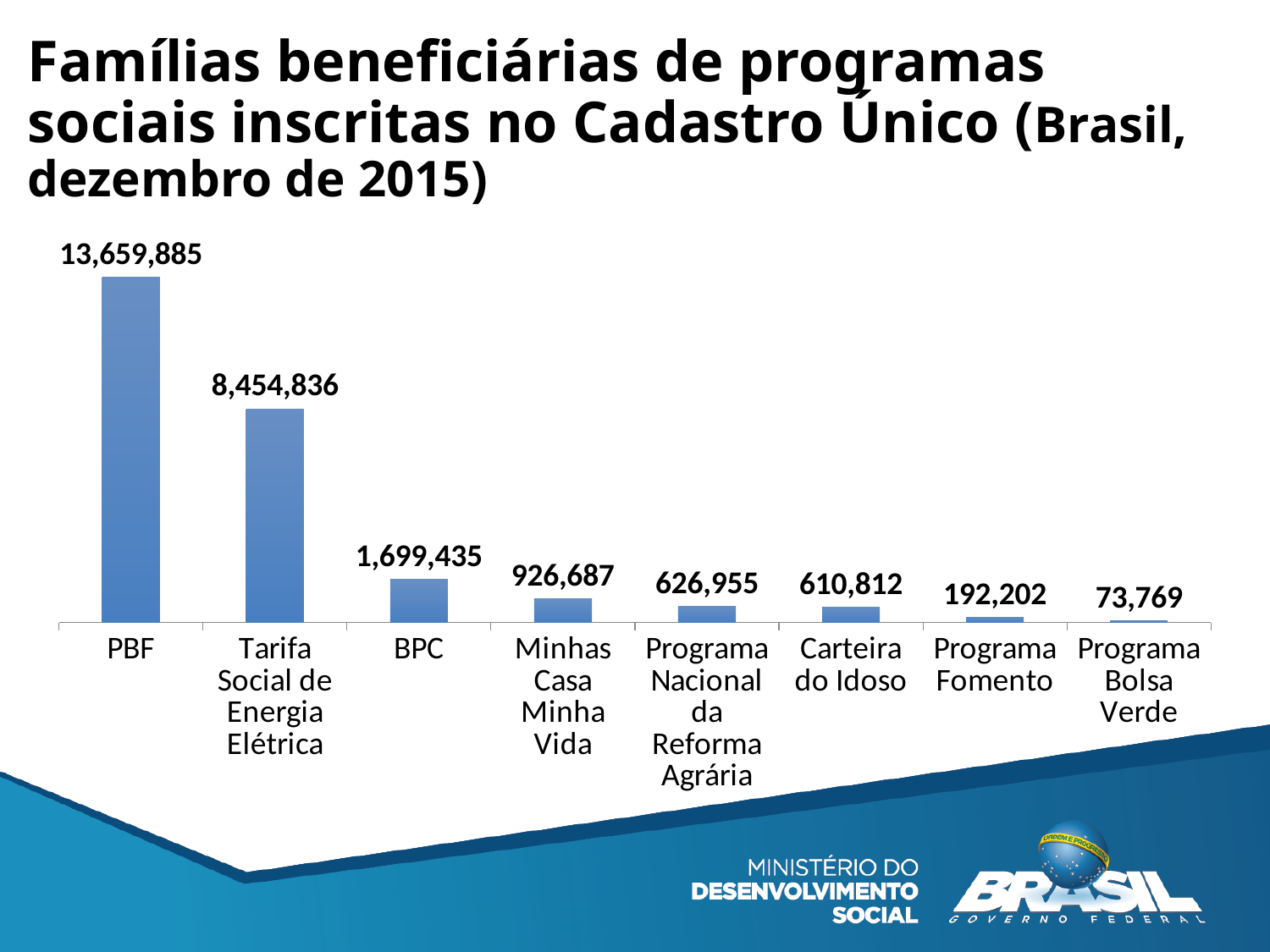
What is the value for Programa Bolsa Verde? 73,769 What is the value for Tarifa Social de Energia Elétrica? 8,454,836 Which category has the lowest value? Programa Bolsa Verde What is the difference between the values for BPC and Minhas Casa Minha Vida? 772,748 What is the value for PBF? 13,659,885 Which category has the highest value? PBF What kind of chart is shown on the slide? Bar chart Which is larger, the value for Programa Fomento or the value for Programa Bolsa Verde? Programa Fomento What is the difference between the values for PBF and Tarifa Social de Energia Elétrica? 5,205,049 How many categories are shown in the chart? 8 What is the value for BPC? 1,699,435 What is the value for Carteira do Idoso? 610,812